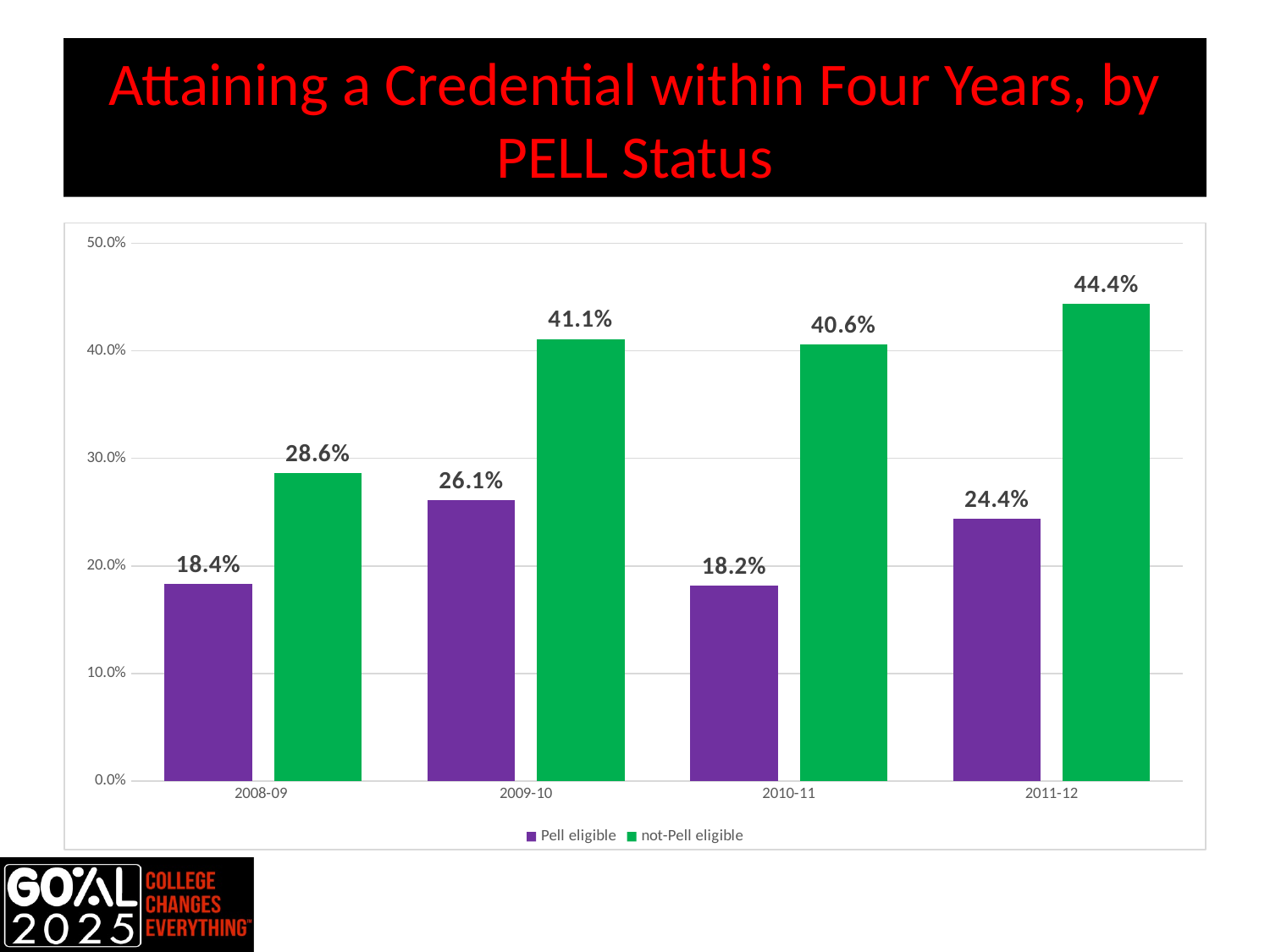
What colour are the bars for not-Pell eligible students? green What is the value for not-Pell eligible students in 2010-11? 40.6% How many years are shown on the x axis? 4 Which is larger in 2009-10: the Pell eligible value or the not-Pell eligible value? not-Pell eligible What is the difference between not-Pell eligible and Pell eligible values in 2011-12? 20.0% Is the value for Pell eligible students in 2010-11 greater or less than 20.0%? less What kind of chart is shown on the slide? bar chart What is the value for not-Pell eligible students in 2011-12? 44.4% Which year has the highest value for Pell eligible students? 2009-10 Which year has the lowest value for not-Pell eligible students? 2008-09 What is the value for Pell eligible students in 2008-09? 18.4% How many series does the legend list? 2